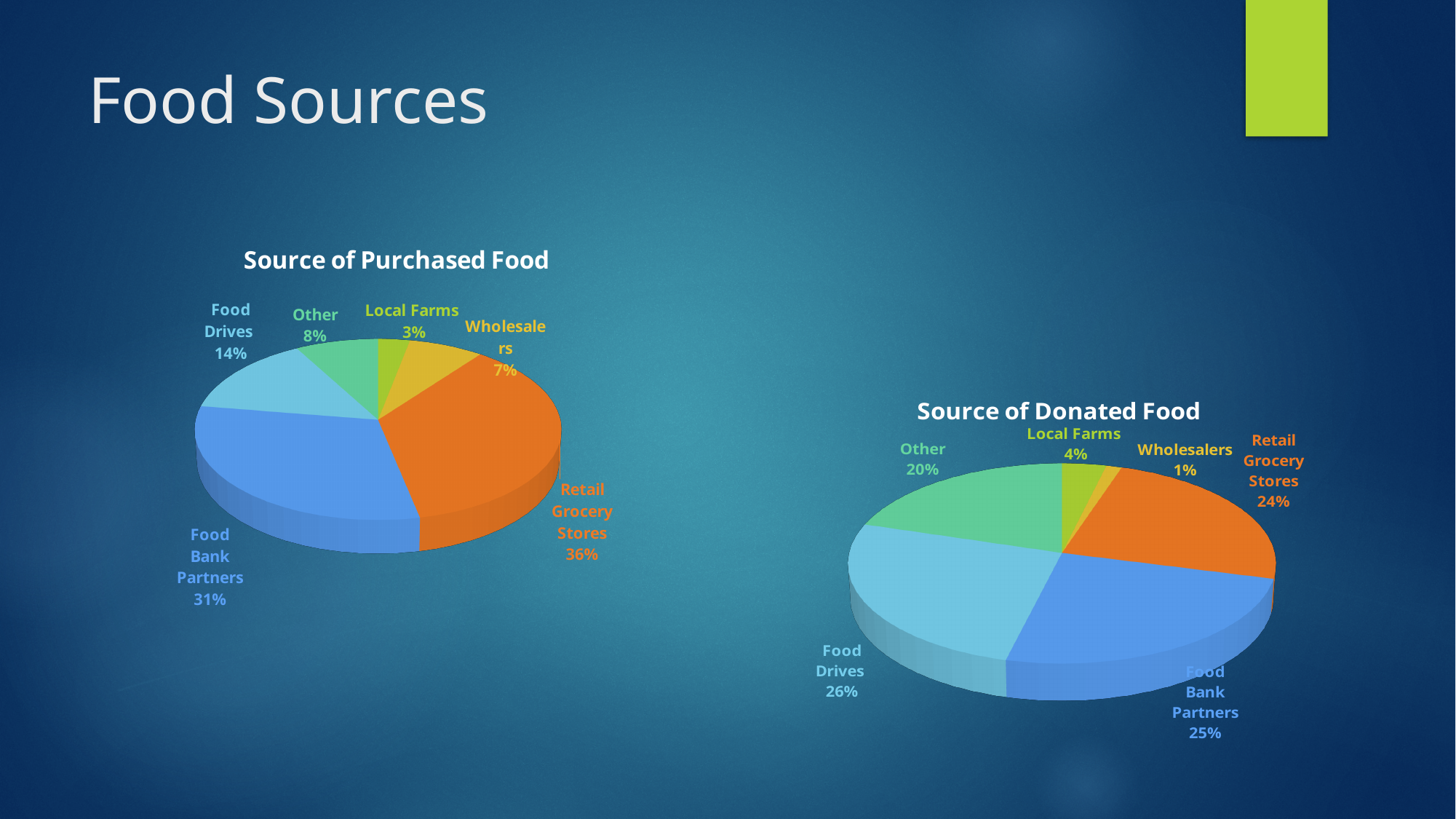
In the Source of Purchased Food chart, which category has the smallest share? Local Farms In the Source of Donated Food chart, which category has the smallest share? Wholesalers In the Source of Purchased Food chart, what share does Wholesalers have? 7% What kind of chart is the Source of Purchased Food chart? Pie chart In the Source of Donated Food chart, which is larger: Other or Food Bank Partners? Food Bank Partners In the Source of Donated Food chart, what is the difference between the shares of Retail Grocery Stores and Local Farms? 20% How many categories are shown in the Source of Donated Food chart? 6 In the Source of Purchased Food chart, what is the difference between the shares of Food Bank Partners and Food Drives? 17% In the Source of Purchased Food chart, which category has the largest share? Retail Grocery Stores What is the title of the chart on the right side of the slide? Source of Donated Food In the Source of Donated Food chart, what share does Food Drives have? 26% In the Source of Purchased Food chart, what share does Retail Grocery Stores have? 36%